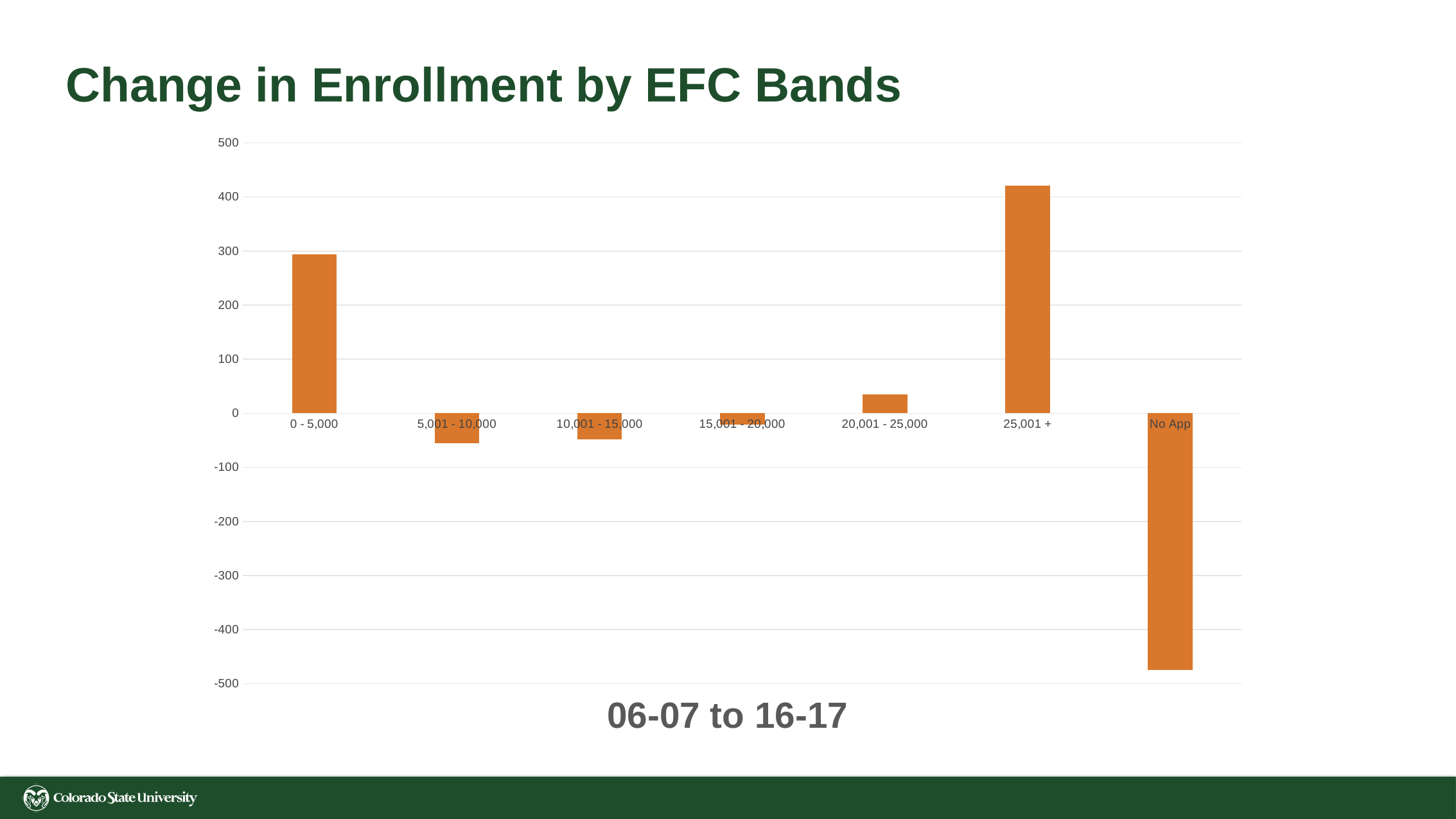
Which is larger, the value for 0 - 5,000 or the value for 25,001 +? 25,001 + Is the value for 20,001 - 25,000 greater or less than 100? less How many EFC band categories are plotted on the chart? 7 Which is larger, the value for 20,001 - 25,000 or the value for 5,001 - 10,000? 20,001 - 25,000 Which category has the lowest change in enrollment? No App Is the value for No App greater or less than -400? less Which category has the highest change in enrollment? 25,001 + What is the title of the chart? Change in Enrollment by EFC Bands What time period is shown in the label below the chart? 06-07 to 16-17 What kind of chart is shown on the slide? bar chart Is the value for 25,001 + greater or less than 400? greater